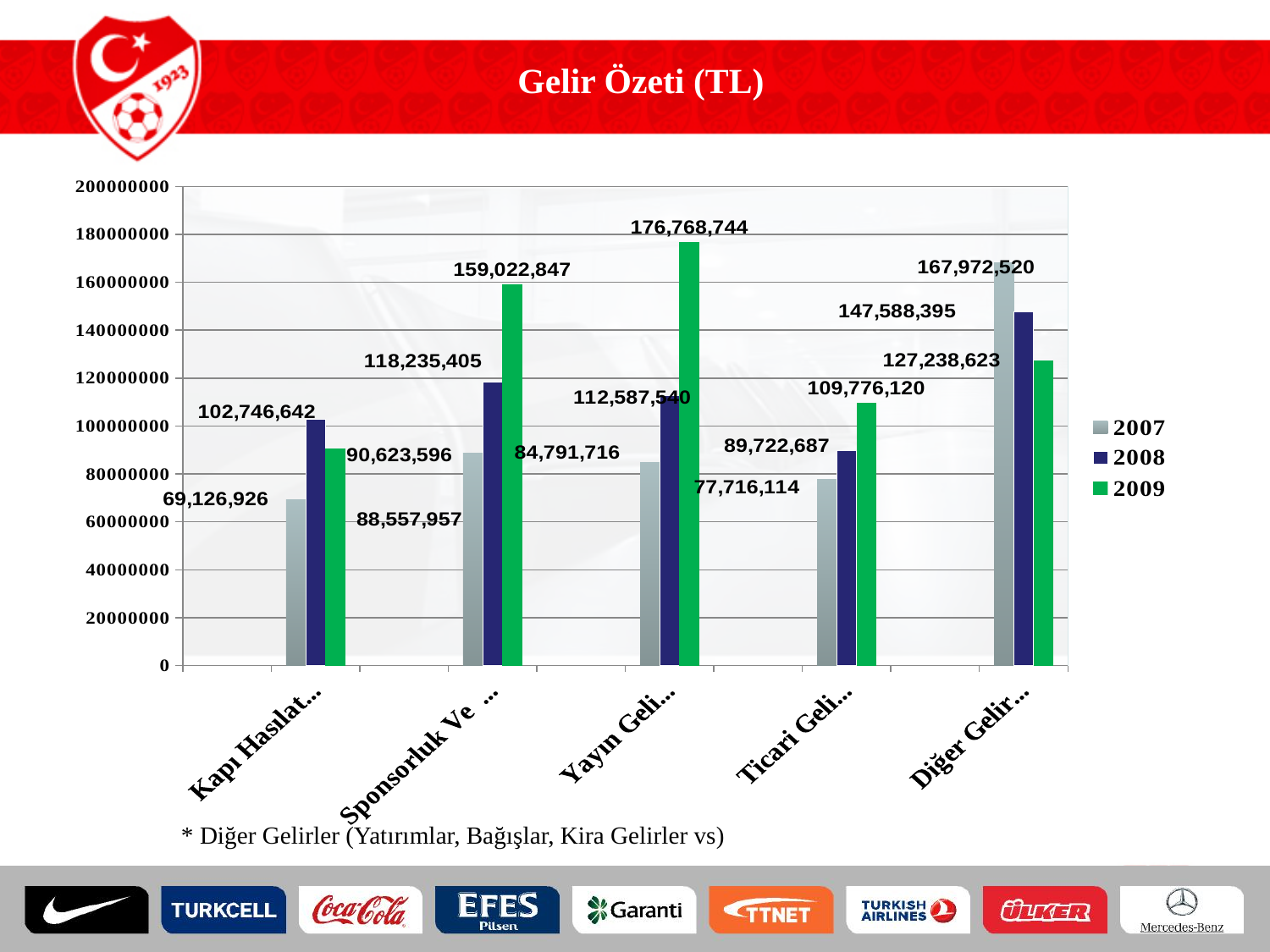
What is the title of the chart? Gelir Özeti (TL) What is the 2009 value for the 'Yayın Geli...' category? 176,768,744 What kind of chart is shown on the slide? Bar chart How many categories are shown on the x axis? 5 Which category has the highest 2009 value? Yayın Geli... What is the 2007 value for the 'Diğer Gelir...' category? 167,972,520 How many series does the legend list? 3 Which category has the lowest 2007 value? Kapı Hasılat... What is the difference between the 2009 and 2008 values for 'Sponsorluk Ve ...'? 40,787,442 What is the 2008 value for the 'Ticari Geli...' category? 89,722,687 For 'Kapı Hasılat...', which is larger, the 2008 value or the 2009 value? 2008 For 'Diğer Gelir...', do the values rise or fall from 2007 to 2009? Fall